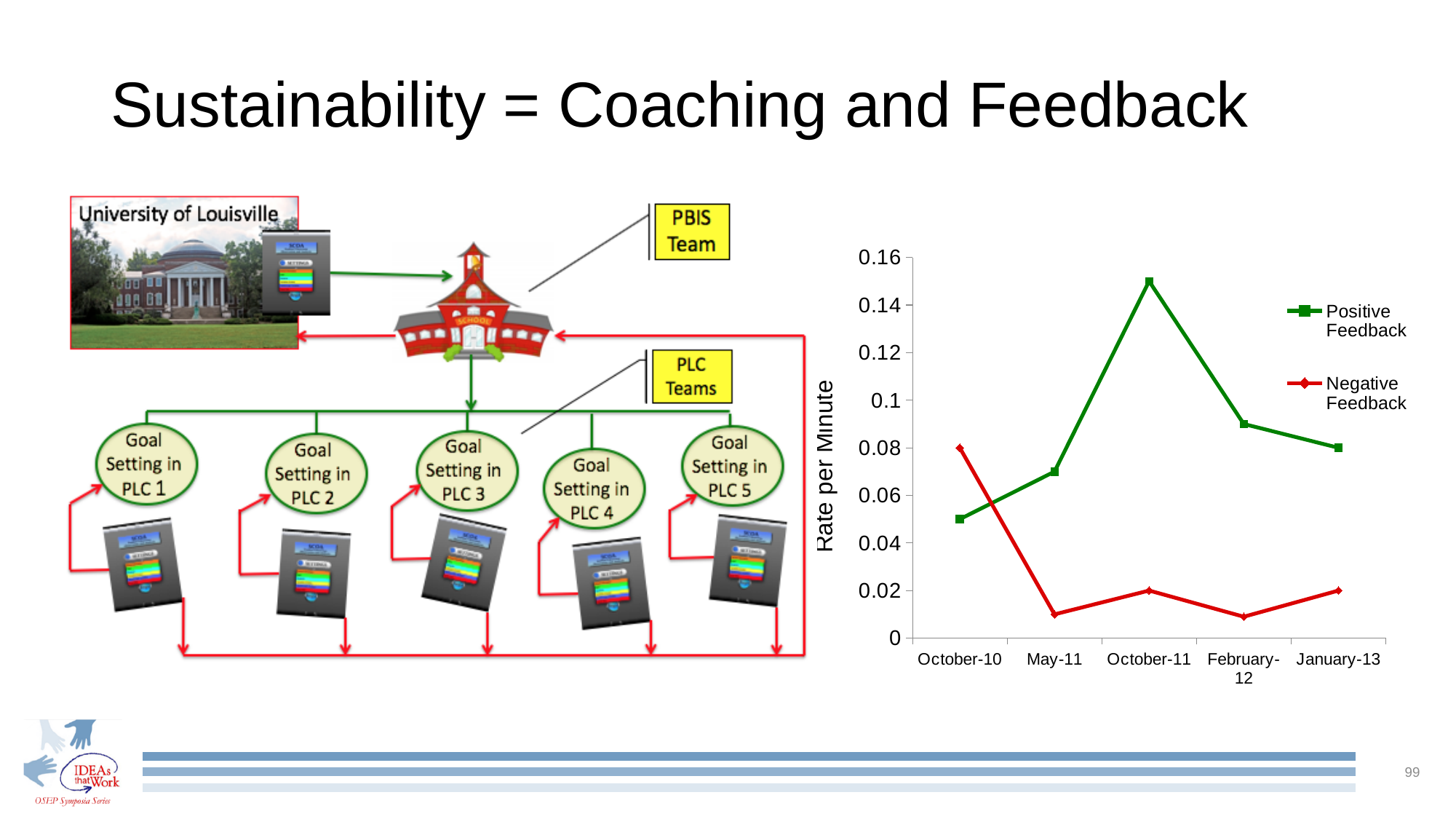
At which time point is Positive Feedback highest? October-11 How many series does the chart's legend list? 2 How many time points are plotted along the x axis of the chart? 5 At which time point is Positive Feedback lowest? October-10 At October-10, which series has the higher value, Positive Feedback or Negative Feedback? Negative Feedback What is the label on the chart's y axis? Rate per Minute At October-11, which series has the higher value, Positive Feedback or Negative Feedback? Positive Feedback Is the Positive Feedback value at October-11 greater or less than 0.14? greater At which time point is Negative Feedback highest? October-10 Is the Positive Feedback value at October-10 greater or less than 0.06? less Does Negative Feedback rise or fall from October-10 to May-11? fall What kind of chart is shown on the slide? line chart